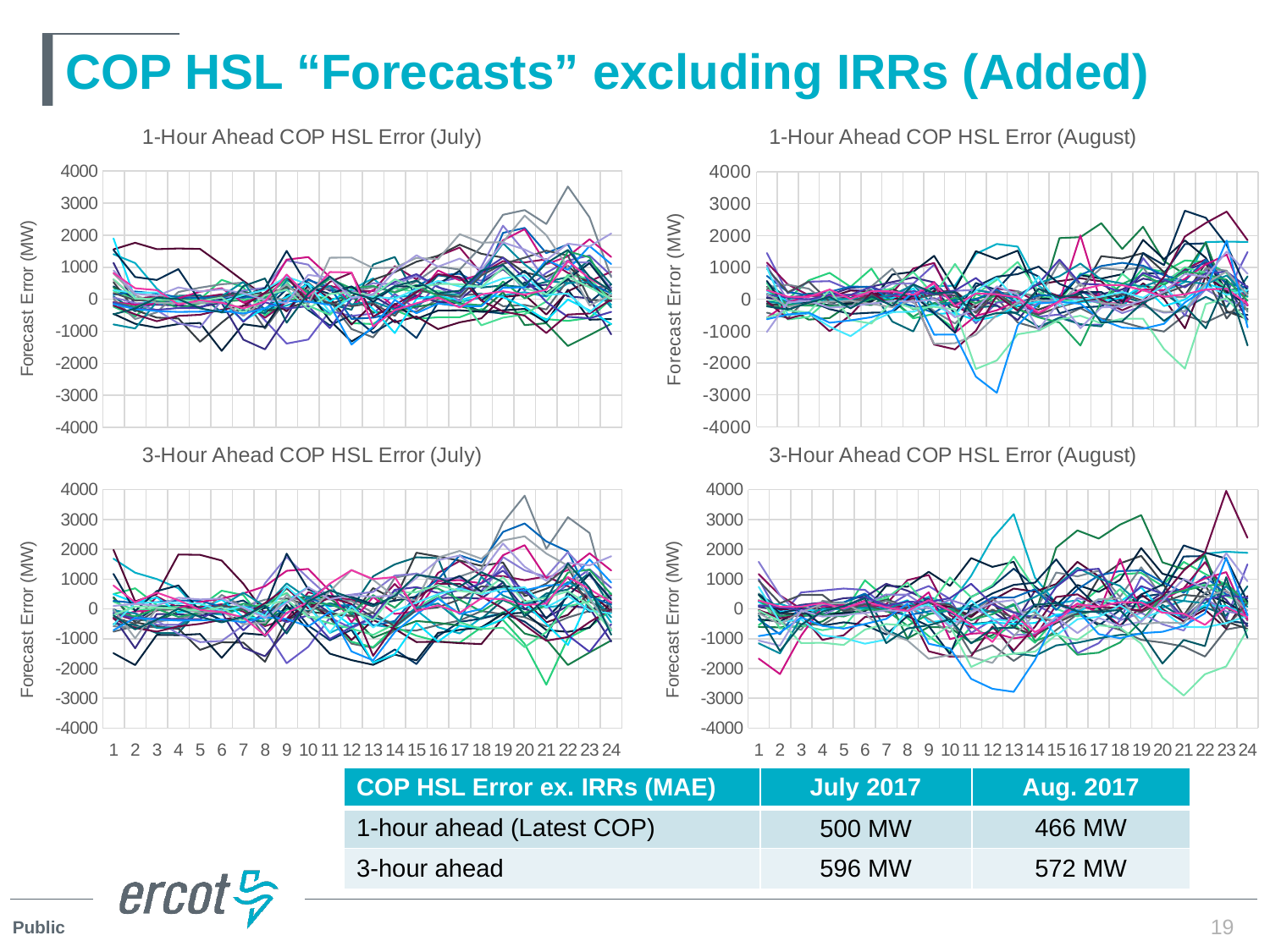
In the 3-Hour Ahead COP HSL Error (July) chart, is the highest peak reached by any line greater or less than 3000? greater What is the highest value shown on the y axis of the 3-Hour Ahead COP HSL Error (August) chart? 4000 How many charts are shown on the slide? 4 In the 1-Hour Ahead COP HSL Error (July) chart, is the highest peak reached by any line greater or less than 3000? greater How many hours are shown along the x axis of the 3-Hour Ahead COP HSL Error (July) chart? 24 What is the lowest value shown on the y axis of the 1-Hour Ahead COP HSL Error (July) chart? -4000 What kind of chart is the 1-Hour Ahead COP HSL Error (July) chart? Line chart What is the title of the chart in the top-right position of the slide? 1-Hour Ahead COP HSL Error (August) In the 1-Hour Ahead COP HSL Error (August) chart, is the lowest point reached by any line greater or less than -2000? less